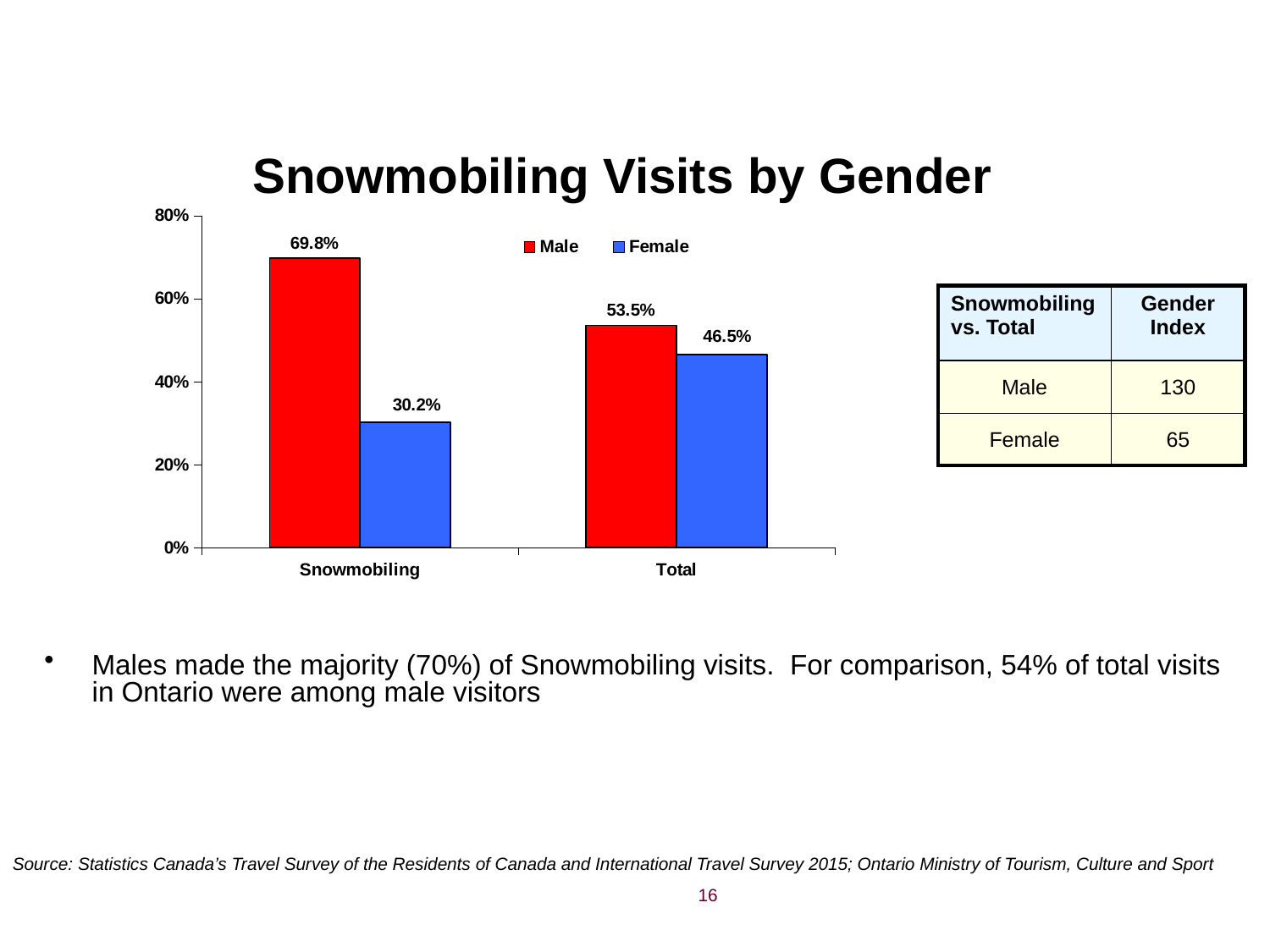
Which category has the highest Male value? Snowmobiling What is the Female value for Total? 46.5% How many categories are shown on the x axis? 2 Which is larger, the Male value for Total or the Female value for Total? Male How many series does the legend list? 2 What is the Female value for Snowmobiling? 30.2% Which category has the lowest Female value? Snowmobiling What is the Male value for Snowmobiling? 69.8% What is the Male value for Total? 53.5% What kind of chart is shown? bar chart What is the difference between the Male and Female values for Snowmobiling? 39.6% Is the Female value for Snowmobiling greater or less than 40%? less